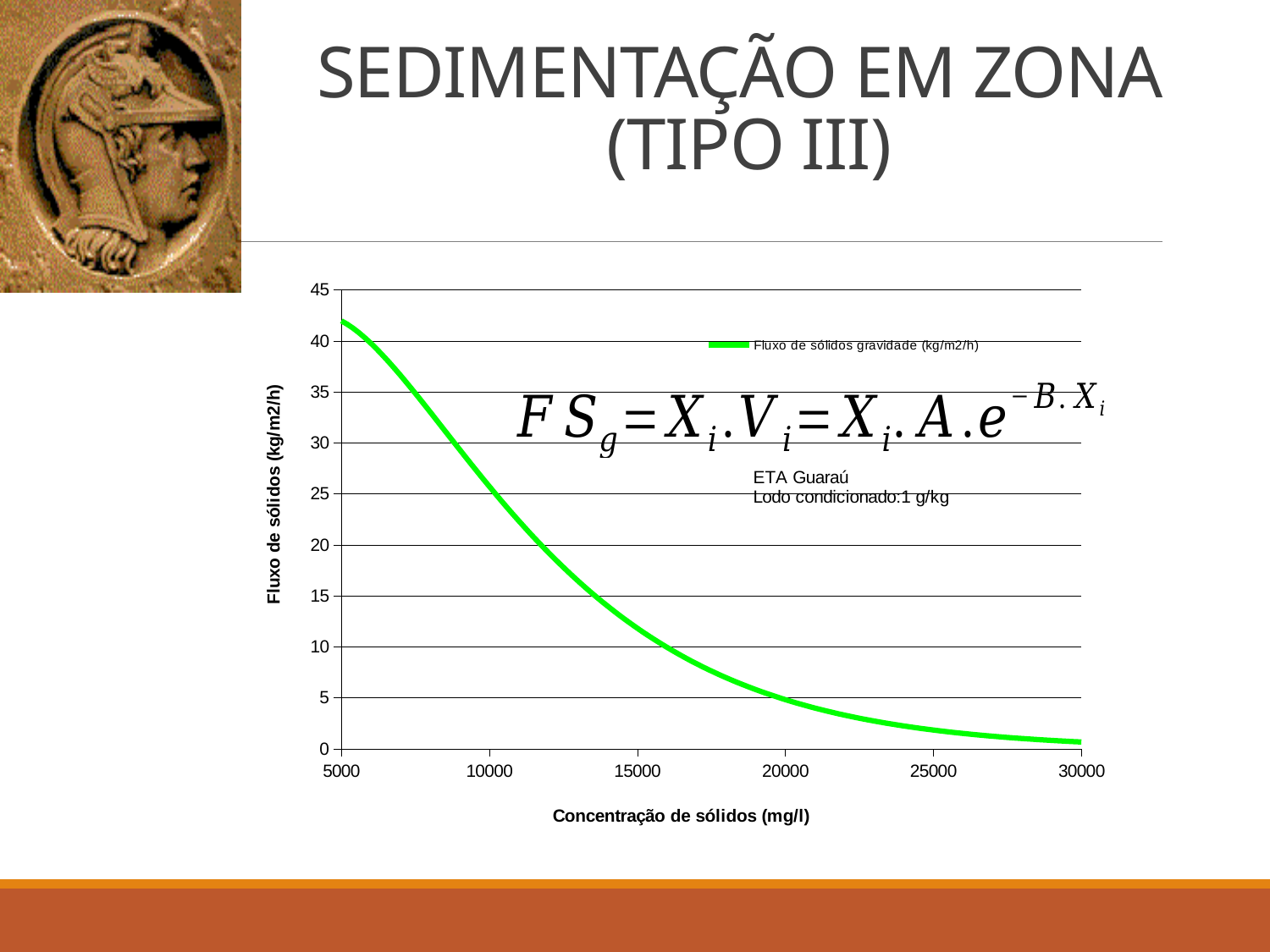
Is the value of Fluxo de sólidos gravidade at a concentration of 20000 mg/l greater or less than 10? less Is the value of Fluxo de sólidos gravidade at a concentration of 15000 mg/l greater or less than 15? less What is the title of the x axis? Concentração de sólidos (mg/l) At which end of the x axis is the solids flux highest, 5000 mg/l or 30000 mg/l? 5000 mg/l Is the value of Fluxo de sólidos gravidade at a concentration of 5000 mg/l greater or less than 40? greater What kind of chart is shown on the slide? line chart How many series does the legend list? 1 Does the solids flux rise or fall as the solids concentration increases along the x axis? fall What is the name of the series shown in the legend? Fluxo de sólidos gravidade (kg/m2/h) Which concentration on the x axis has the higher solids flux, 5000 mg/l or 25000 mg/l? 5000 mg/l